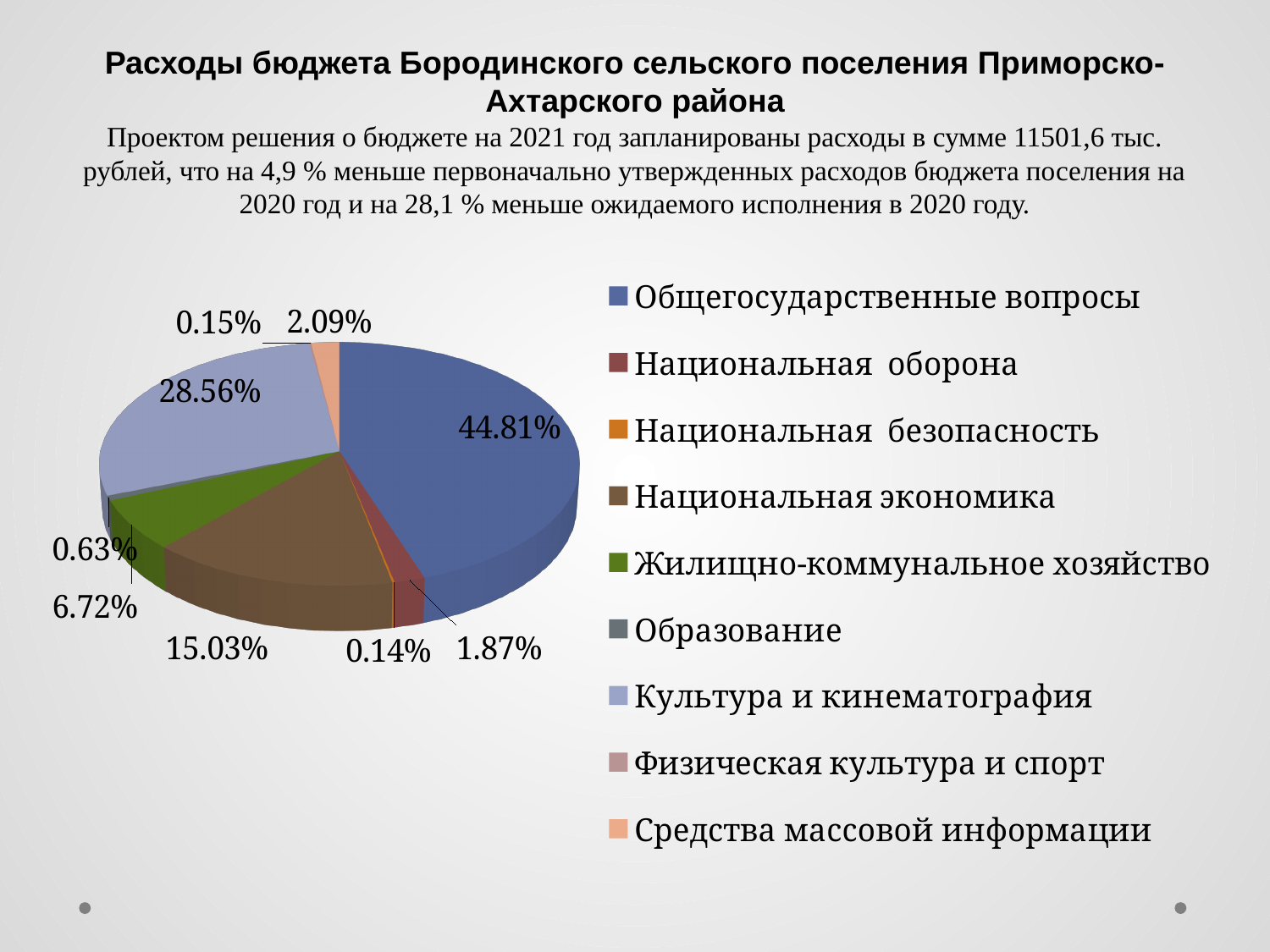
What is the difference between the share for Общегосударственные вопросы and the share for Культура и кинематография? 16.25% What share of the pie does Национальная экономика have? 15.03% Which category has the largest share of the pie? Общегосударственные вопросы What kind of chart is shown on the slide? pie chart What share of the pie does Жилищно-коммунальное хозяйство have? 6.72% What share of the pie does Общегосударственные вопросы have? 44.81% How many categories does the legend of the pie chart list? 9 What colour is the slice for Жилищно-коммунальное хозяйство? green Which is larger: the share for Национальная экономика or the share for Культура и кинематография? Культура и кинематография Which category has the smallest share of the pie? Национальная безопасность